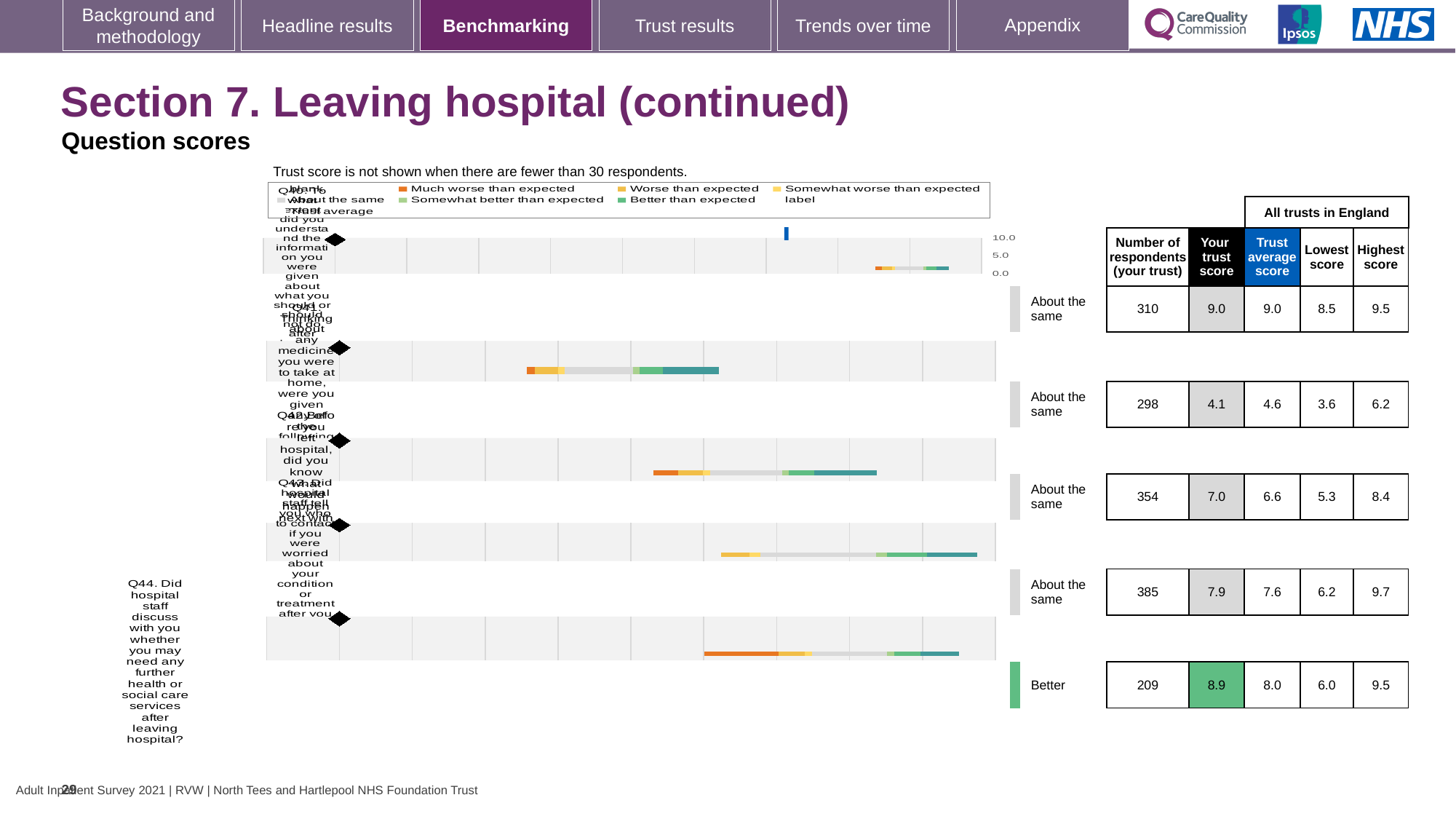
What is the 'Your trust score' value for Q44 (Did hospital staff discuss with you whether you may need any further health or social care services after leaving hospital?)? 8.9 Is the trust score for Q44 greater or less than 5.0 on the chart's axis? greater Which question on this slide is rated 'Better' rather than 'About the same'? Q44 What is the lowest 'Your trust score' value shown in the table on this slide? 4.1 How many question rows are plotted on the chart? 5 By how much does the 'Your trust score' for Q44 exceed the 'Trust average score' for Q44? 0.9 What is the highest 'Your trust score' value shown in the table on this slide? 9.0 How many respondents (your trust) are shown for Q44? 209 What is the 'Highest score' across all trusts in England for Q44? 9.5 What is the 'Trust average score' for Q44? 8.0 What kind of chart is used to show the question scores on this slide? Bar chart For Q44, which is larger: the 'Your trust score' or the 'Trust average score'? Your trust score